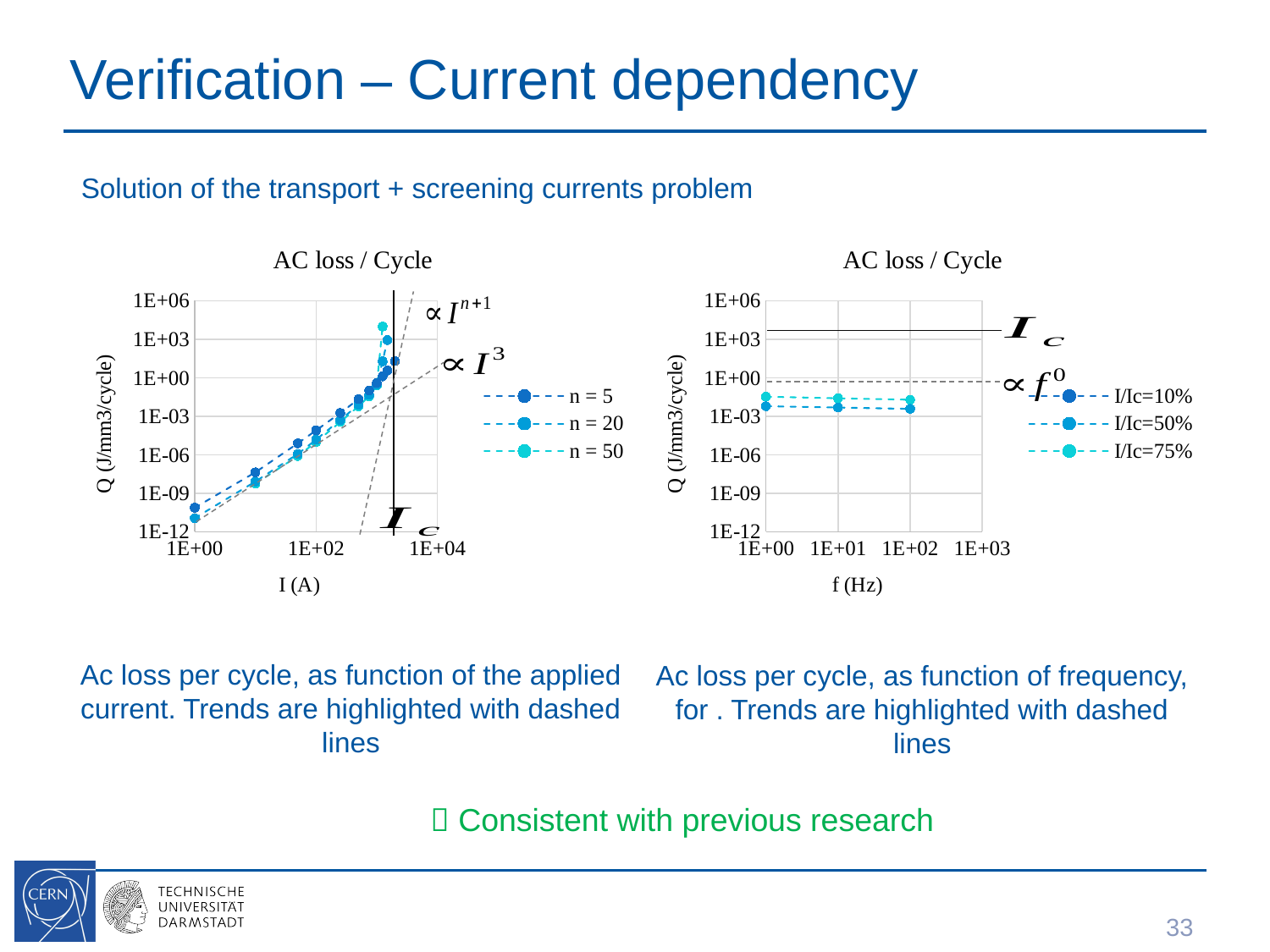
In the right chart, what is the label of the x axis? f (Hz) In the right chart, is the value for I/Ic=75% at 1E+00 Hz greater or less than 1E+00? less In the left chart, is the value for n = 5 at I = 1E+00 A greater or less than 1E-09? less In the left chart, what is the label of the y axis? Q (J/mm3/cycle) What is the title of the chart on the left side of the slide? AC loss / Cycle In the left chart, do the AC loss values rise or fall as the current I increases? rise In the left chart, what is the label of the x axis? I (A) In the left chart (AC loss / Cycle vs I), how many series does the legend list? 3 In the left chart, what are the three series named in the legend? n = 5, n = 20, n = 50 In the right chart, do the AC loss values rise, fall, or stay roughly flat as the frequency f increases? stay roughly flat In the right chart (AC loss / Cycle vs f), how many series does the legend list? 3